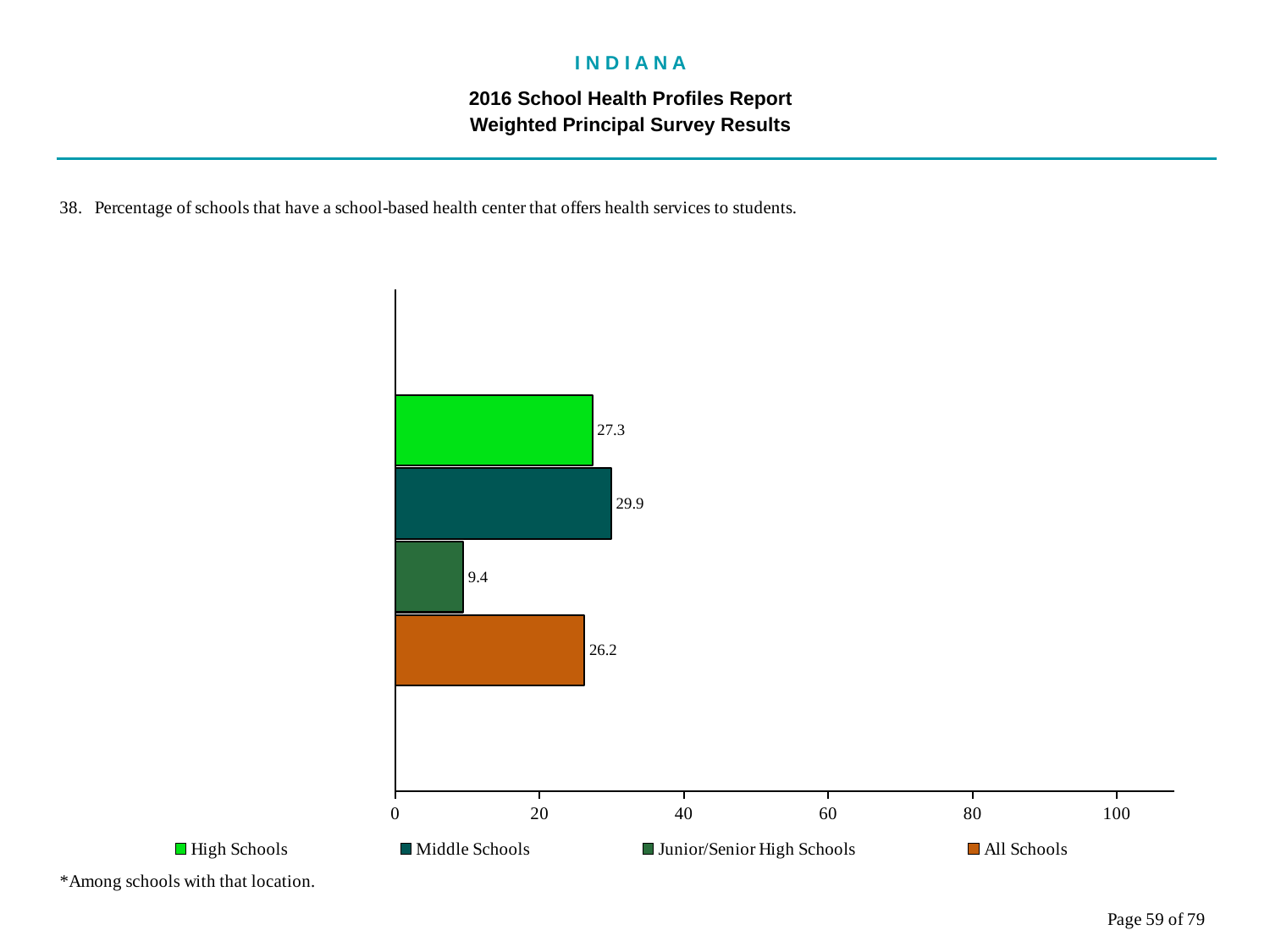
Which is larger, the value for Middle Schools or the value for High Schools? Middle Schools What is the value for Middle Schools? 29.9 What kind of chart is shown on the slide? bar chart What is the difference between the values for High Schools and All Schools? 1.1 What is the difference between the values for Middle Schools and Junior/Senior High Schools? 20.5 Is the value for Junior/Senior High Schools greater or less than 20? less What is the value for Junior/Senior High Schools? 9.4 What is the value for High Schools? 27.3 Which school type has the lowest value? Junior/Senior High Schools Which school type has the highest value? Middle Schools How many series does the legend list? 4 What is the value for All Schools? 26.2